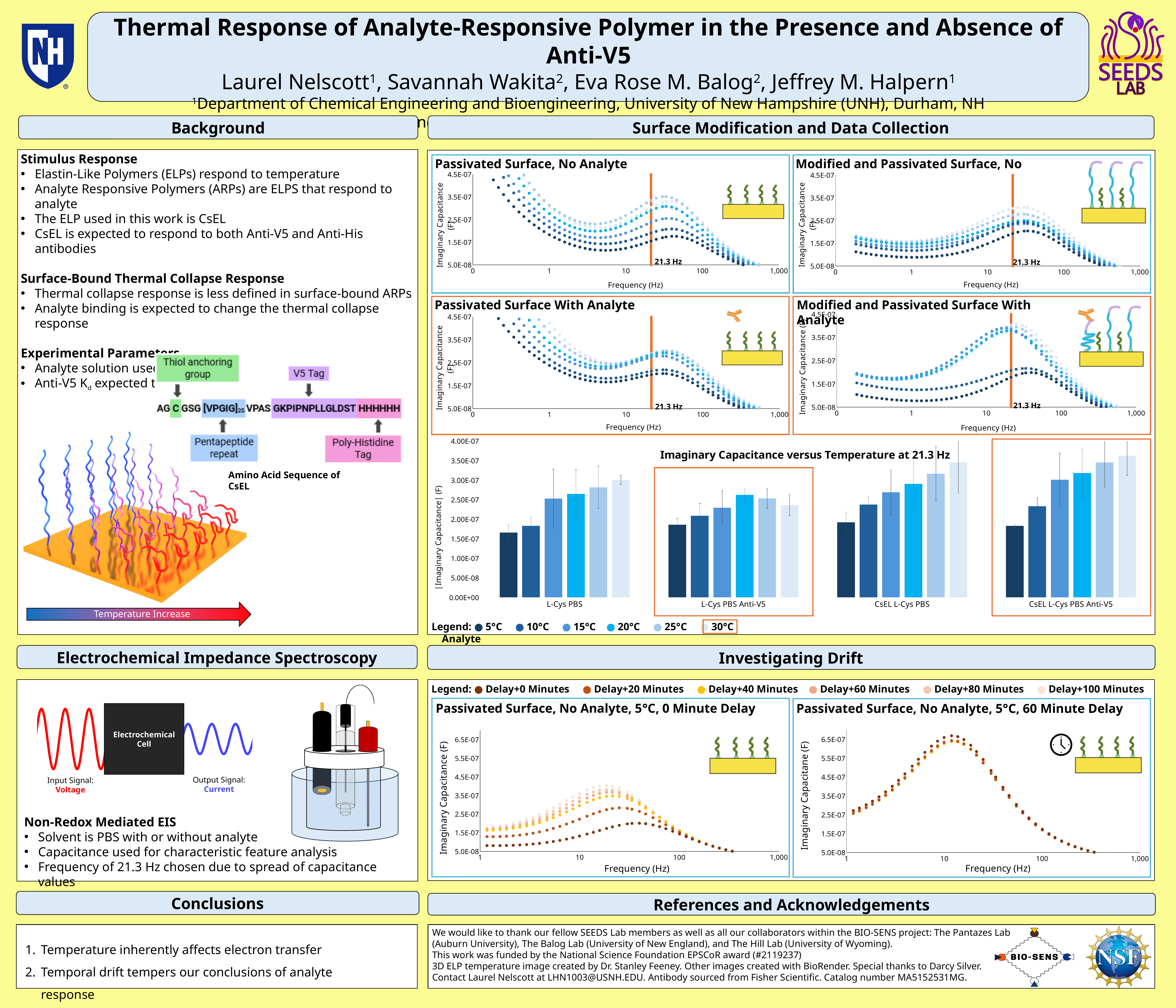
How many categories (surface conditions) are shown on the x axis of the 'Imaginary Capacitance versus Temperature at 21.3 Hz' bar chart? 4 What kind of chart is 'Imaginary Capacitance versus Temperature at 21.3 Hz'? bar chart In the 'Passivated Surface, No Analyte, 5°C, 60 Minute Delay' chart, is the peak imaginary capacitance greater or less than 5.5E-07? greater In the 'Imaginary Capacitance versus Temperature at 21.3 Hz' bar chart, which temperature is shown by the darkest blue bars? 5°C How many temperature series does the legend of the 'Imaginary Capacitance versus Temperature at 21.3 Hz' bar chart list? 6 In the 'Imaginary Capacitance versus Temperature at 21.3 Hz' bar chart, for the L-Cys PBS group, which bar is larger: 5°C or 30°C? 30°C In the 'Imaginary Capacitance versus Temperature at 21.3 Hz' bar chart, is the 5°C bar for L-Cys PBS greater or less than 2.00E-07? less What frequency is marked by the vertical orange line in the 'Passivated Surface, No Analyte' chart? 21.3 Hz In the 'Passivated Surface, No Analyte, 5°C, 60 Minute Delay' chart, do the values rise or fall as frequency increases from 10 Hz to 1,000 Hz? fall In the 'Imaginary Capacitance versus Temperature at 21.3 Hz' bar chart, is the 30°C bar for CsEL L-Cys PBS Anti-V5 greater or less than 3.00E-07? greater How many delay series does the legend in the 'Investigating Drift' section list? 6 In the 'Imaginary Capacitance versus Temperature at 21.3 Hz' bar chart, do the bars within the CsEL L-Cys PBS Anti-V5 group rise or fall as temperature increases from 5°C to 30°C? rise